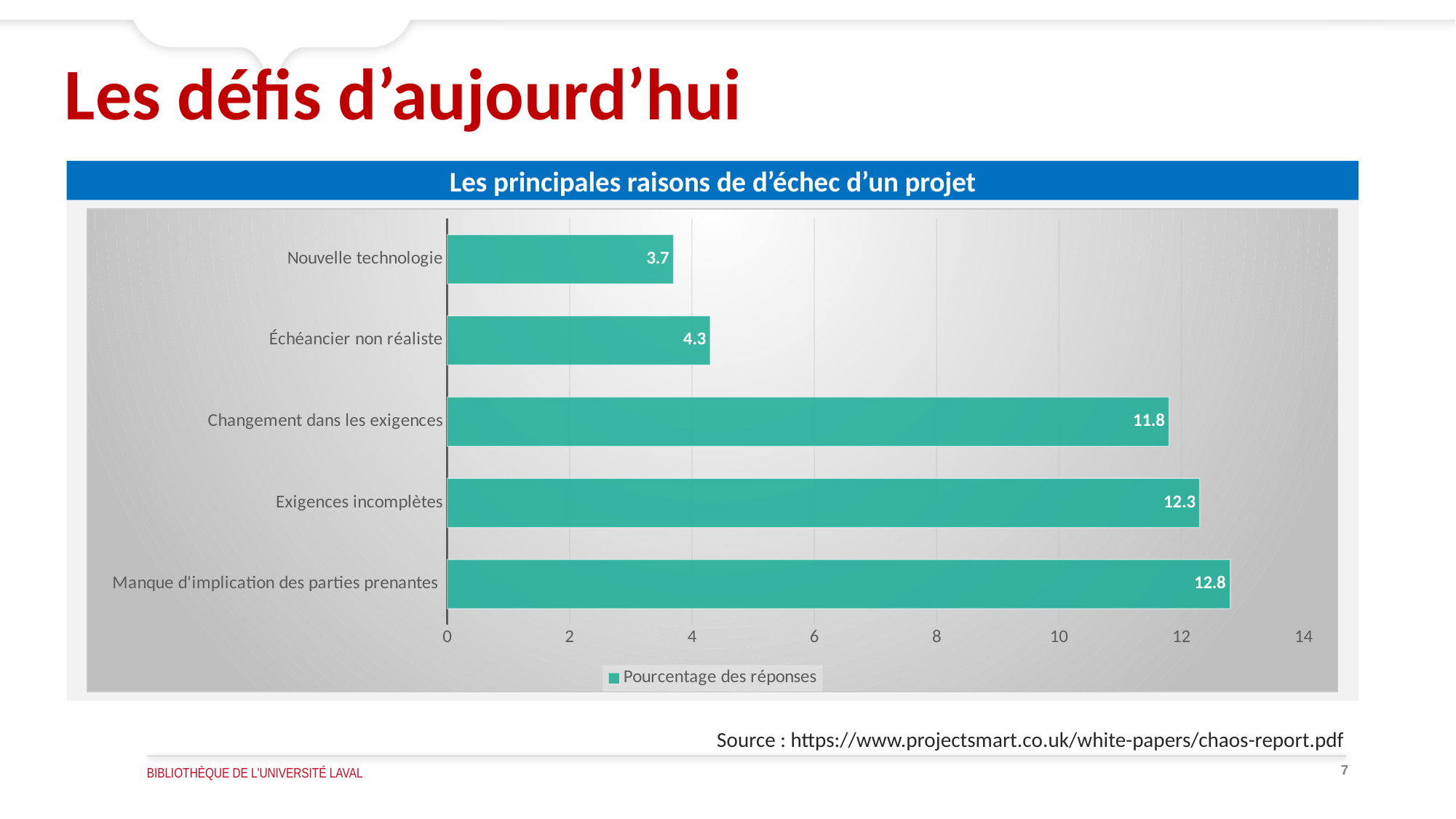
What is the title of the chart? Les principales raisons de d’échec d’un projet Which category has the lowest value? Nouvelle technologie What is the value for Changement dans les exigences? 11.8 What is the value for Nouvelle technologie? 3.7 How many series does the legend list? 1 What is the difference between the values for Exigences incomplètes and Échéancier non réaliste? 8 How many categories are shown in the chart? 5 Which category has the highest value? Manque d'implication des parties prenantes Which is larger, the value for Échéancier non réaliste or the value for Nouvelle technologie? Échéancier non réaliste What is the value for Manque d'implication des parties prenantes? 12.8 Is the value for Changement dans les exigences greater or less than 10? greater What kind of chart is shown? bar chart